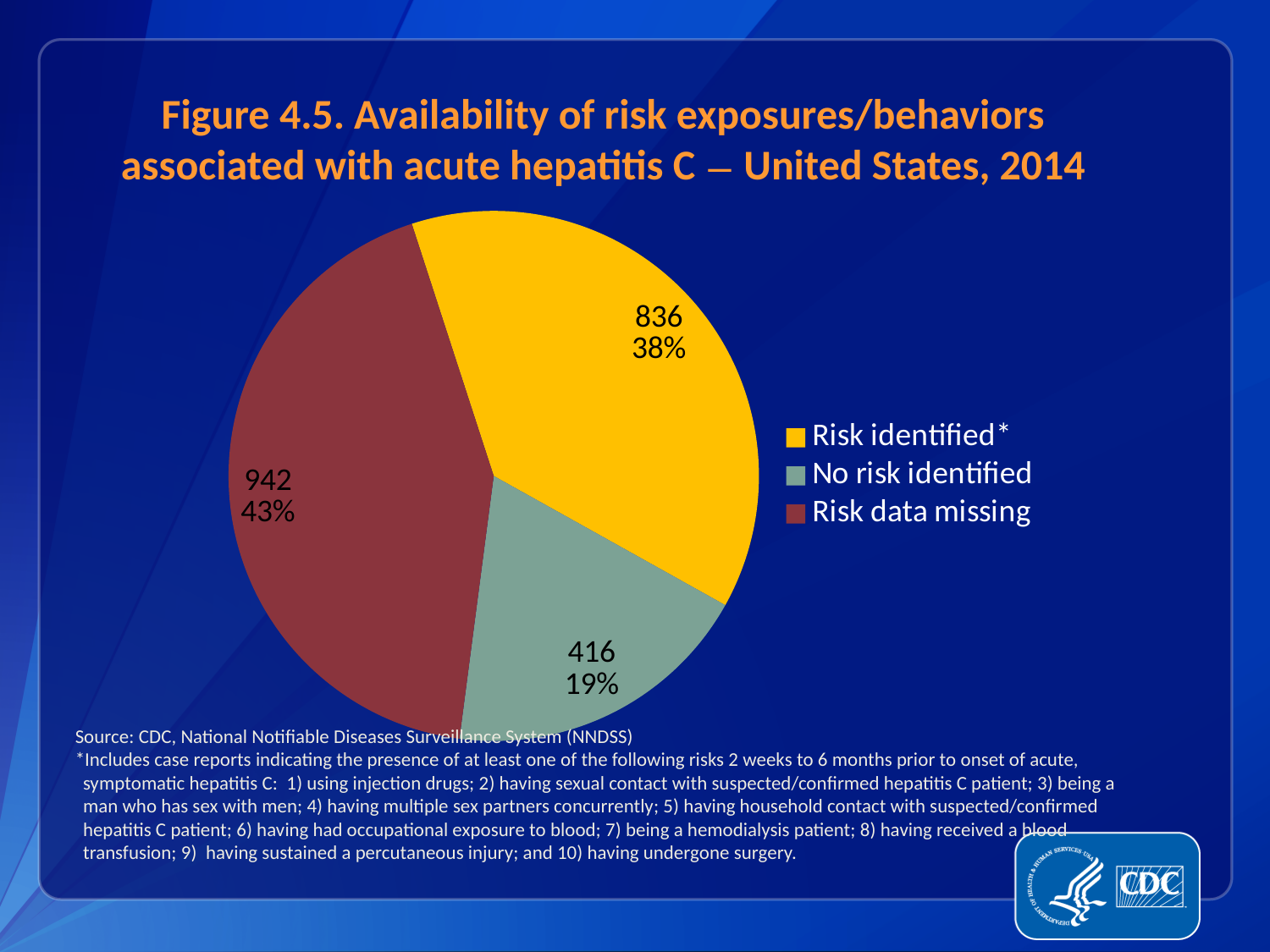
How many entries does the legend list? 3 What is the number of cases for 'Risk identified*'? 836 Which category has the smallest slice? No risk identified What share of the pie does 'Risk data missing' represent? 43% What is the number of cases for 'Risk data missing'? 942 What is the difference in cases between 'Risk data missing' and 'Risk identified*'? 106 What is the number of cases for 'No risk identified'? 416 Which colour represents 'Risk identified*' in the pie chart? yellow Which category has the largest slice? Risk data missing What kind of chart is shown on the slide? pie chart What share of the pie does 'No risk identified' represent? 19% How many slices does the pie chart have? 3